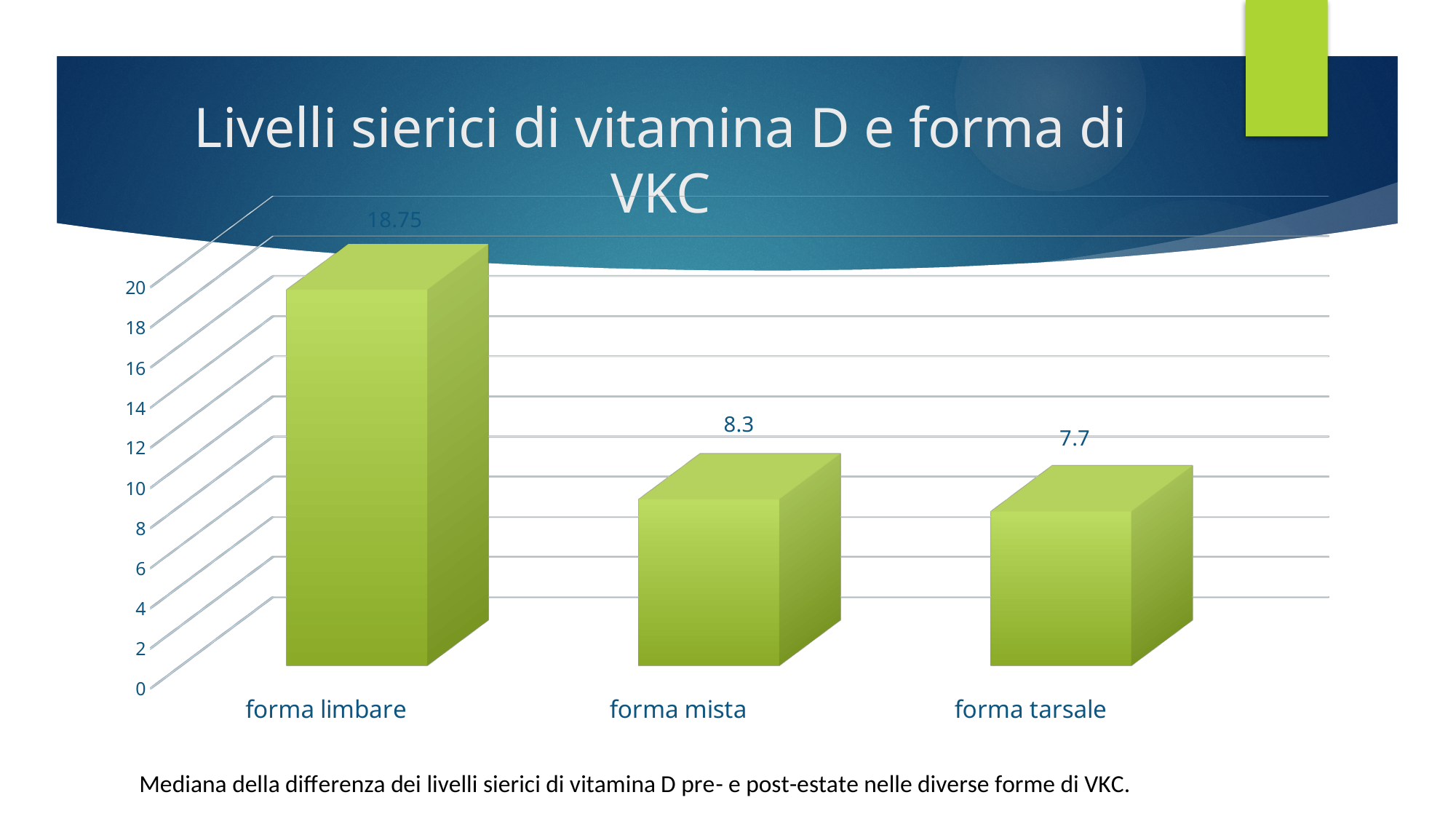
Which category has the lowest value? forma tarsale What is the difference between the values for forma mista and forma tarsale? 0.6 Is the value for forma mista greater or less than 10? less What is the difference between the values for forma limbare and forma mista? 10.45 What is the value for forma tarsale? 7.7 What is the value for forma limbare? 18.75 What is the value for forma mista? 8.3 Which is larger, the value for forma limbare or the value for forma tarsale? forma limbare What is the title of the slide containing the chart? Livelli sierici di vitamina D e forma di VKC Which category has the highest value? forma limbare How many categories are shown in the chart? 3 What kind of chart is shown on the slide? bar chart